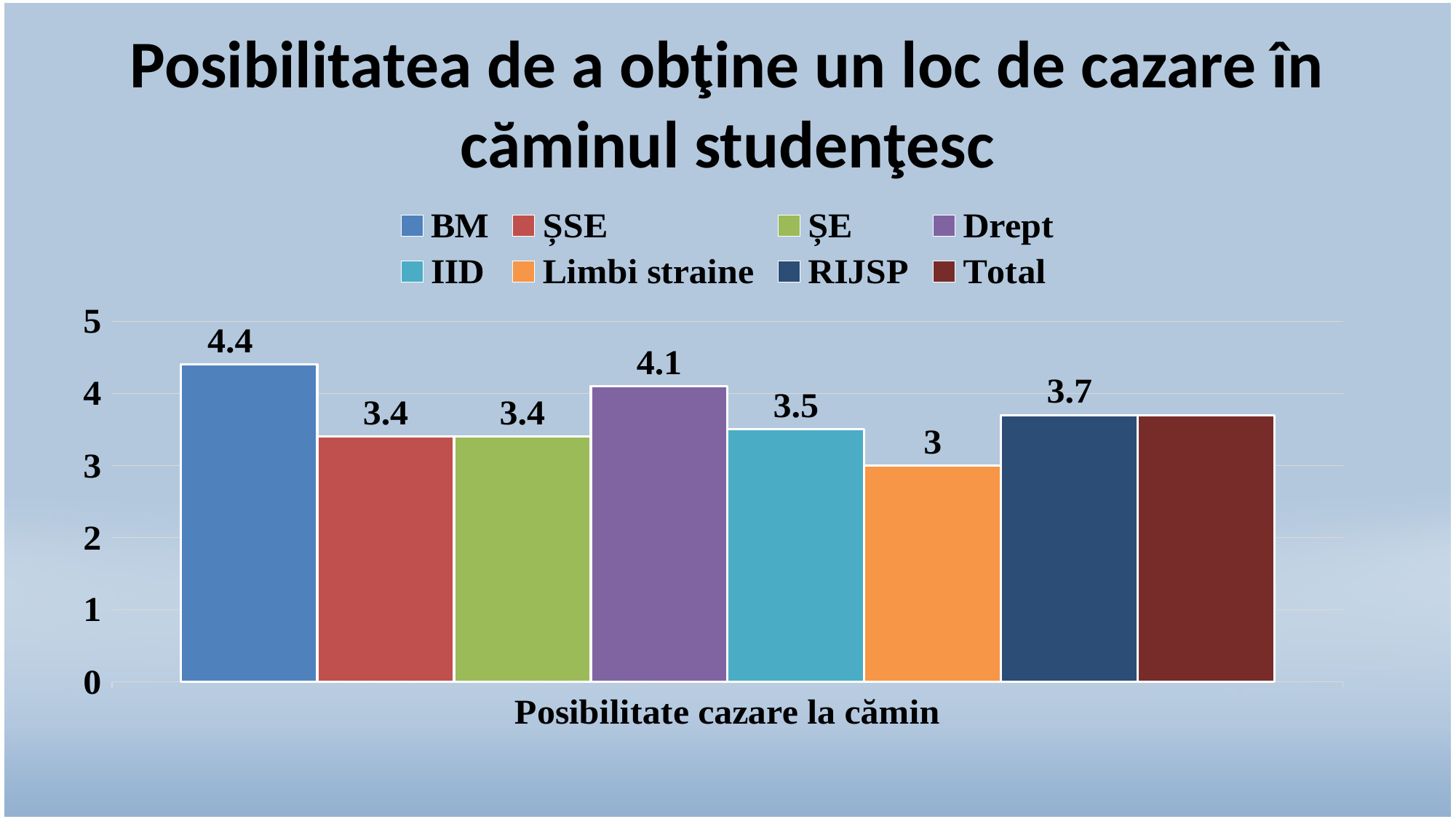
What is the label shown on the x axis below the bars? Posibilitate cazare la cămin Is the value for Total greater or less than 4? less What is the value for RIJSP? 3.7 Which series has the lowest value? Limbi straine What is the value for Limbi straine? 3 Which series has the highest value? BM How many series does the legend list? 8 What is the difference between the values for BM and Limbi straine? 1.4 What kind of chart is shown on the slide? bar chart Which is larger, the value for IID or the value for Drept? Drept What is the value for BM? 4.4 What is the value for Drept? 4.1